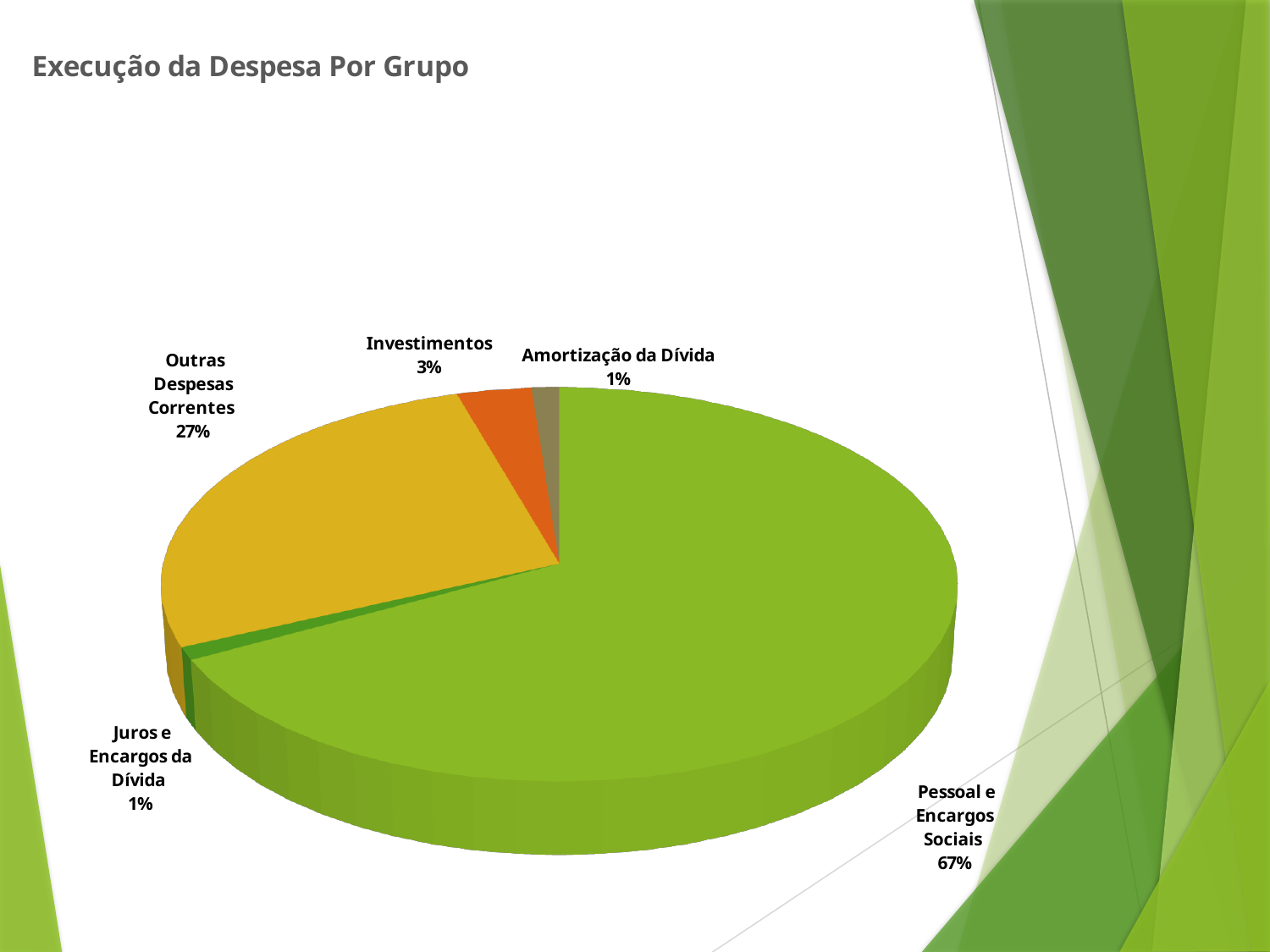
What colour is the slice for Outras Despesas Correntes? Yellow What is the value shown for Investimentos? 3% What is the difference in percentage points between Pessoal e Encargos Sociais and Outras Despesas Correntes? 40 percentage points What share of the pie does Pessoal e Encargos Sociais represent? 67% What is the title of the chart? Execução da Despesa Por Grupo What is the difference in percentage points between Outras Despesas Correntes and Investimentos? 24 percentage points Which is larger, Investimentos or Amortização da Dívida? Investimentos Which category has the largest share of the pie? Pessoal e Encargos Sociais What kind of chart is shown on the slide? Pie chart What is the value shown for Outras Despesas Correntes? 27% What is the value shown for Amortização da Dívida? 1% How many slices does the pie chart have? 5